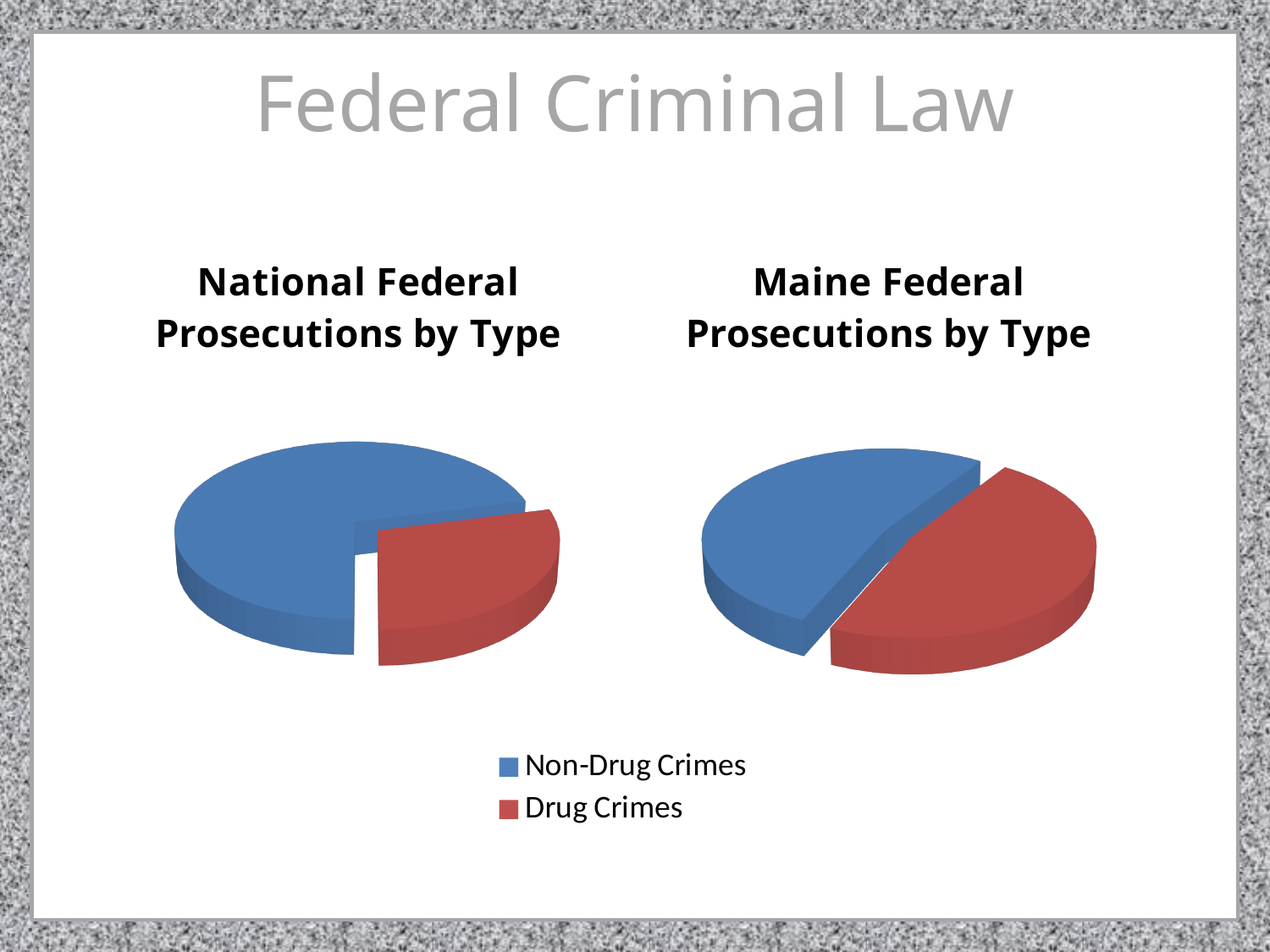
How many slices does the "National Federal Prosecutions by Type" pie chart have? 2 Which colour represents Drug Crimes in the pie charts? Red In the "National Federal Prosecutions by Type" chart, which is larger: Non-Drug Crimes or Drug Crimes? Non-Drug Crimes What kind of chart is the "National Federal Prosecutions by Type" chart? Pie chart In the "National Federal Prosecutions by Type" chart, which category has the smallest slice? Drug Crimes What kind of chart is the "Maine Federal Prosecutions by Type" chart? Pie chart In the "National Federal Prosecutions by Type" chart, which category has the largest slice? Non-Drug Crimes What is the title of the pie chart on the right side of the slide? Maine Federal Prosecutions by Type How many slices does the "Maine Federal Prosecutions by Type" pie chart have? 2 How many categories does the shared legend list for the pie charts? 2